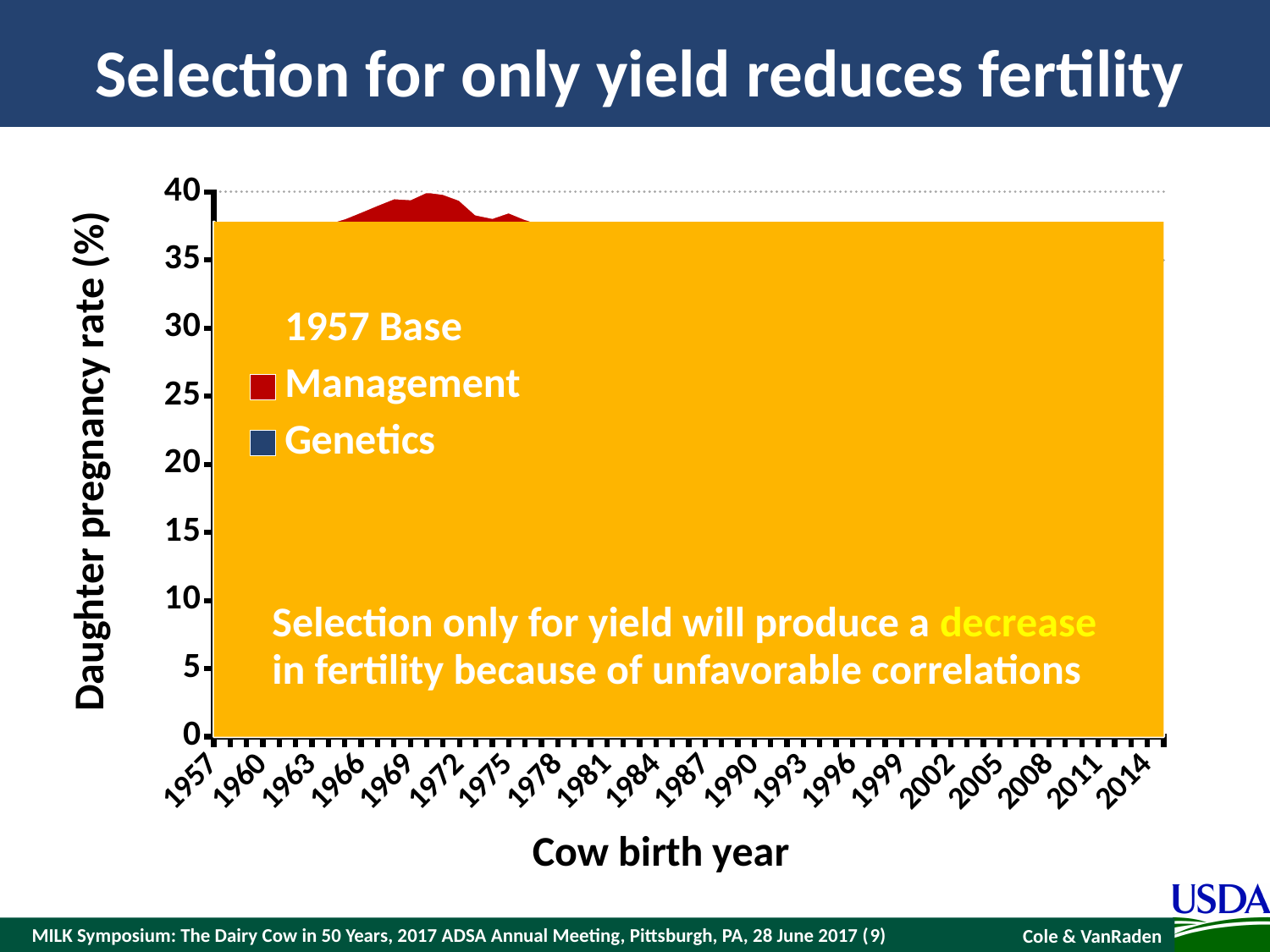
What kind of chart is shown on the slide? area chart Is the top of the red Management area around 1971 greater or less than 35? greater Which colour represents Management in the chart legend? red What is the label of the chart's y axis? Daughter pregnancy rate (%) How many year labels are shown along the x axis of the chart? 20